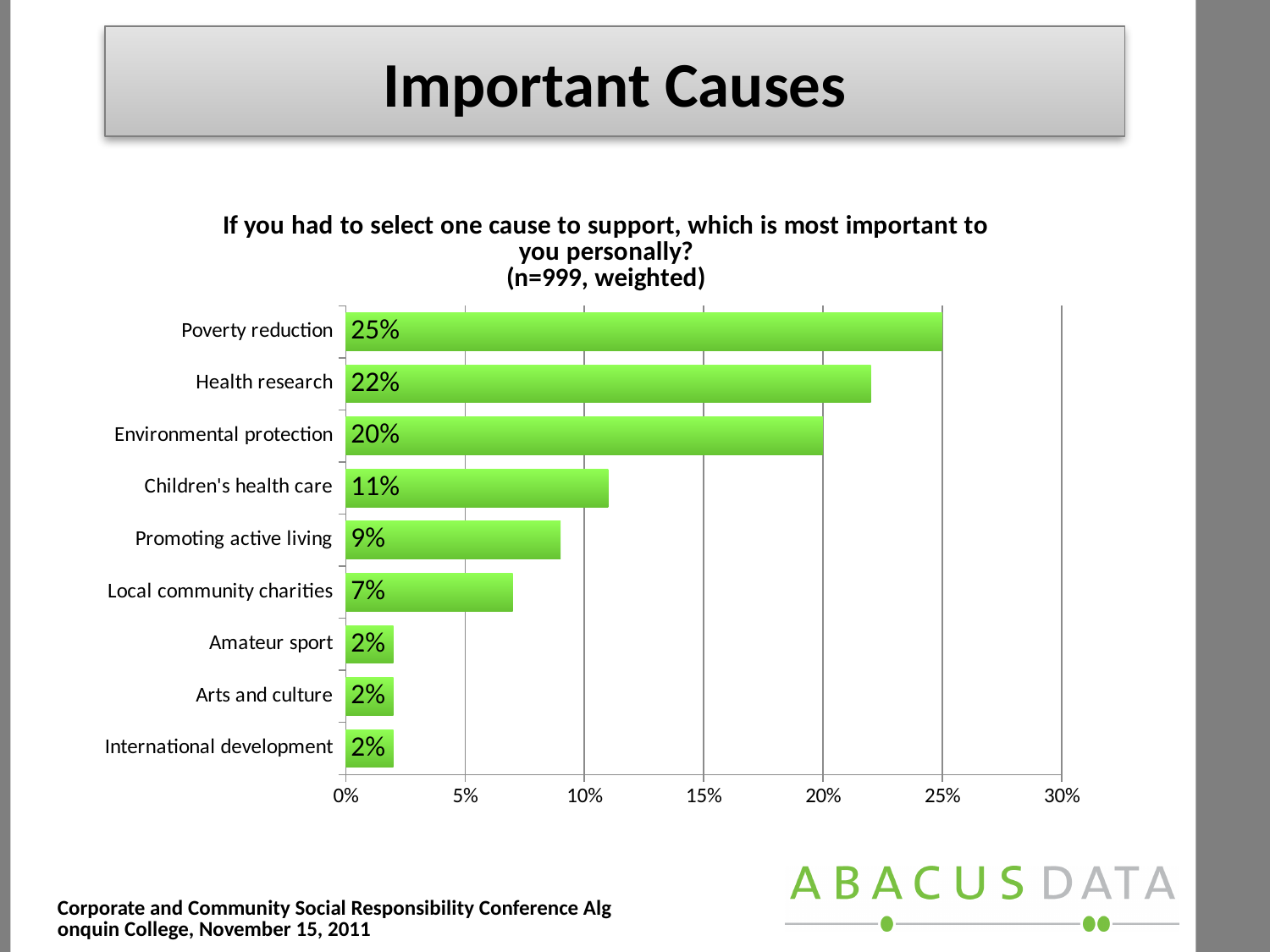
What percentage of respondents selected Poverty reduction as the most important cause? 25% How many causes are shown in the chart? 9 What percentage is shown for Children's health care? 11% What is the difference between Health research and Promoting active living? 13% What kind of chart is shown on the slide? Bar chart Is the value for Promoting active living greater or less than 10%? less What is the value for Local community charities? 7% Which has a larger value, Environmental protection or Children's health care? Environmental protection What is the sample size stated in the chart title? n=999, weighted What is the value shown for Health research? 22% What is the difference between the values for Poverty reduction and Environmental protection? 5% Which cause has the highest percentage? Poverty reduction